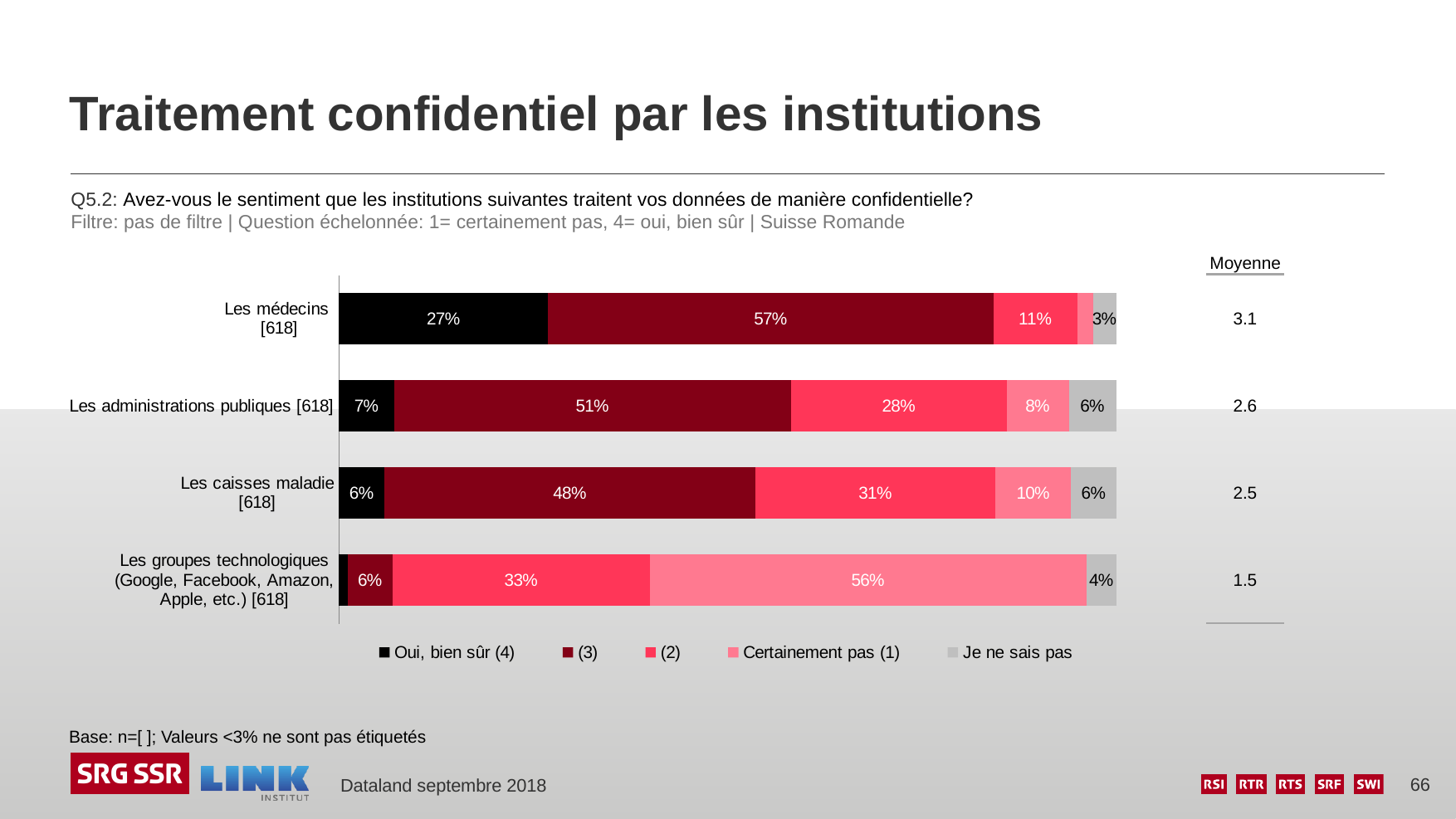
What is the "Je ne sais pas" share for Les administrations publiques? 6% How many institutions are shown in the chart? 4 Which institution has the lowest Moyenne value? Les groupes technologiques (Google, Facebook, Amazon, Apple, etc.) What is the "(3)" share for Les administrations publiques? 51% Which institution has the highest "Oui, bien sûr (4)" share? Les médecins What type of chart is shown on the slide? Stacked bar chart How many series does the legend list? 5 What is the Moyenne (mean) shown for Les caisses maladie? 2.5 What percentage of respondents answered "Oui, bien sûr (4)" for Les médecins? 27% Which is larger: the "(3)" share for Les médecins or for Les caisses maladie? Les médecins What percentage answered "Certainement pas (1)" for Les groupes technologiques (Google, Facebook, Amazon, Apple, etc.)? 56% What is the difference between the "(2)" share for Les caisses maladie and for Les administrations publiques? 3%